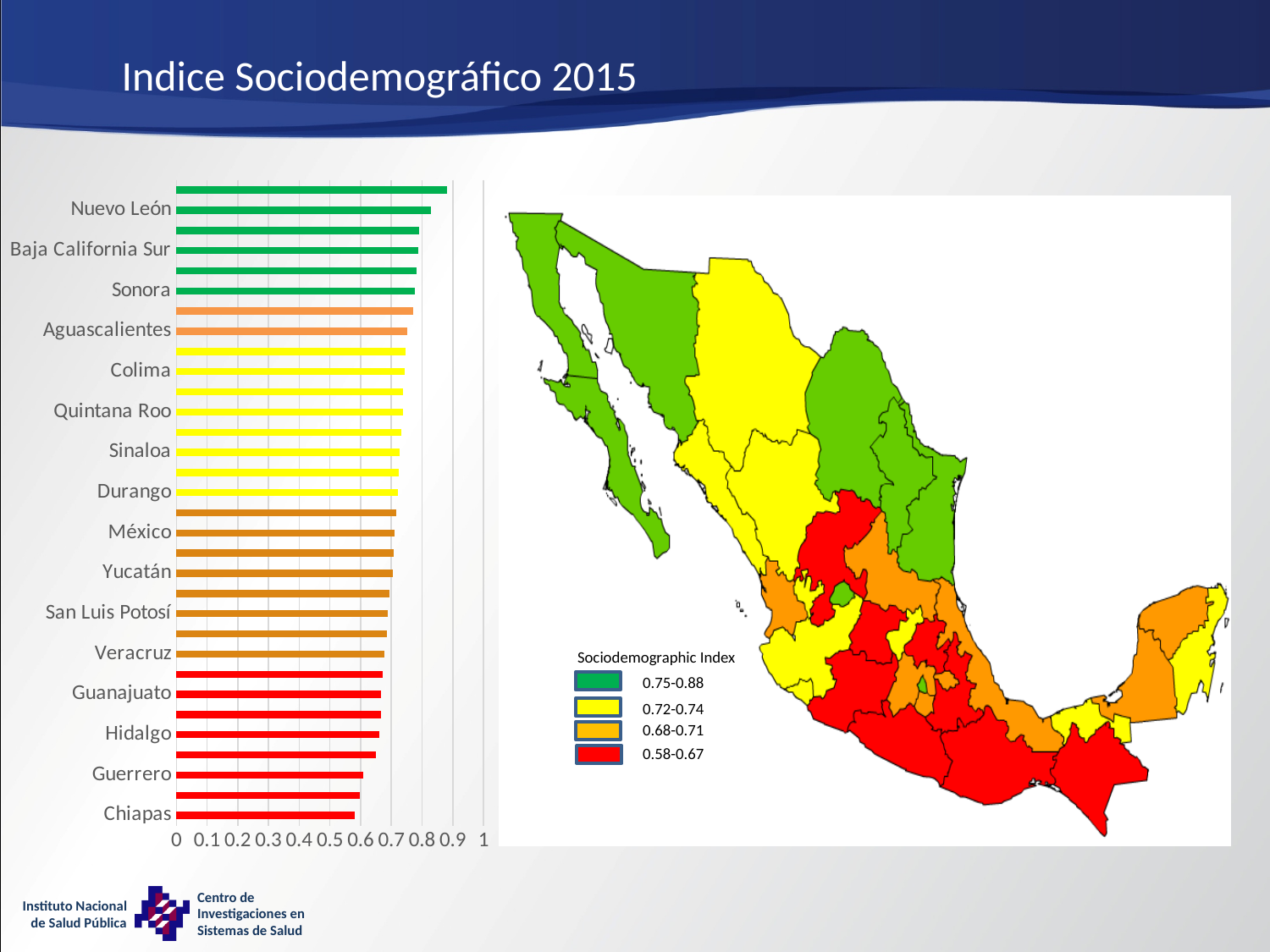
What range does the green colour represent in the map legend? 0.75-0.88 Is the value for Nuevo León greater or less than 0.7? greater Is the value for México greater or less than 0.8? less Which has the larger value, Nuevo León or Chiapas? Nuevo León Is the value for Durango greater or less than 0.6? greater Which has the larger value, Sonora or Guerrero? Sonora Which labelled state has the shortest bar in the bar chart? Chiapas What kind of chart is shown on the left of the slide? bar chart Going from the top of the bar chart to the bottom, do the bars get longer or shorter? shorter